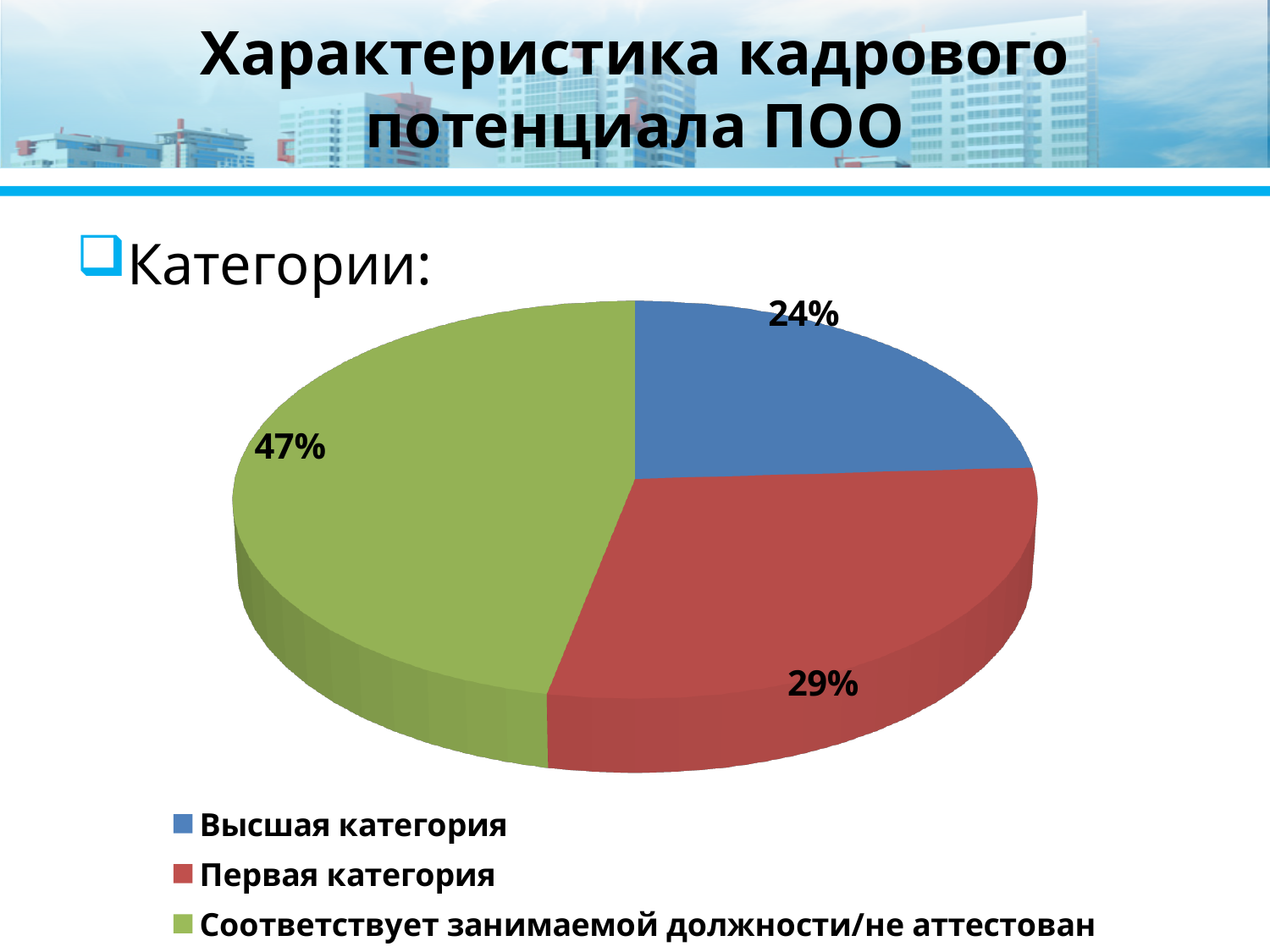
Which is larger: the share for "Первая категория" or the share for "Высшая категория"? Первая категория What colour is the slice for "Первая категория"? Red What kind of chart is shown on the slide? Pie chart What share of the pie does "Первая категория" represent? 29% Which category has the smallest slice of the pie? Высшая категория What is the difference in percentage points between "Первая категория" and "Высшая категория"? 5 How many categories does the pie chart show? 3 What share of the pie does "Соответствует занимаемой должности/не аттестован" represent? 47% Which category has the largest slice of the pie? Соответствует занимаемой должности/не аттестован What is the title of the slide containing the chart? Характеристика кадрового потенциала ПОО What share of the pie does "Высшая категория" represent? 24% What is the difference in percentage points between "Соответствует занимаемой должности/не аттестован" and "Первая категория"? 18